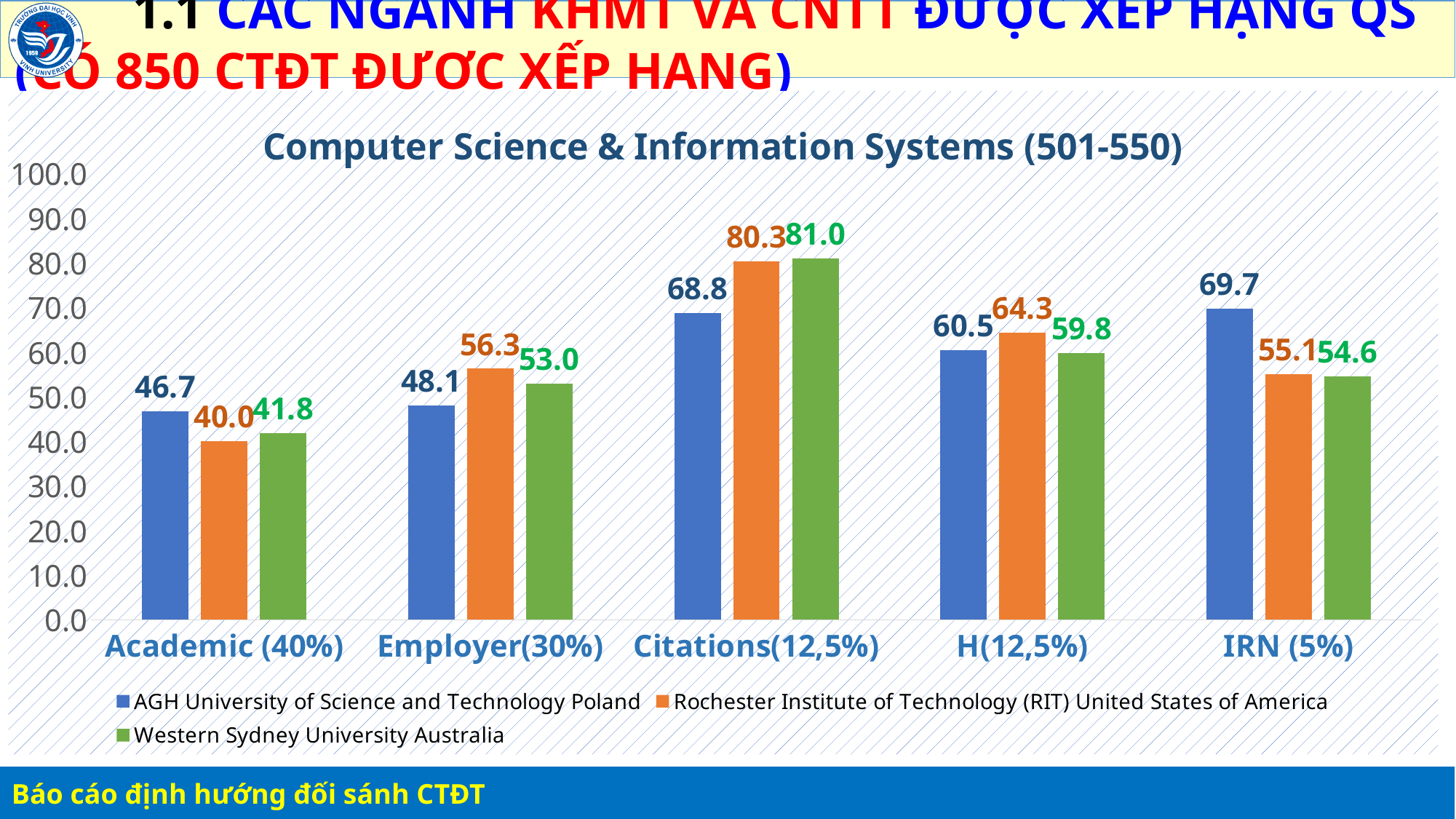
In which category does AGH University of Science and Technology Poland have its highest value? IRN (5%) What is the value for Rochester Institute of Technology (RIT) United States of America in the H(12,5%) category? 64.3 Is the value for Rochester Institute of Technology (RIT) United States of America in the Academic (40%) category greater or less than 50.0? less What is the title of the chart? Computer Science & Information Systems (501-550) What kind of chart is shown on the slide? bar chart What is the value for Western Sydney University Australia in the Employer(30%) category? 53.0 How many series does the legend list? 3 In the IRN (5%) category, which university has the larger value: AGH University of Science and Technology Poland or Western Sydney University Australia? AGH University of Science and Technology Poland What is the difference between the Western Sydney University Australia value and the AGH University of Science and Technology Poland value in the Citations(12,5%) category? 12.2 How many categories are shown on the x axis? 5 In which category does Rochester Institute of Technology (RIT) United States of America have its lowest value? Academic (40%) What is the value for AGH University of Science and Technology Poland in the Citations(12,5%) category? 68.8